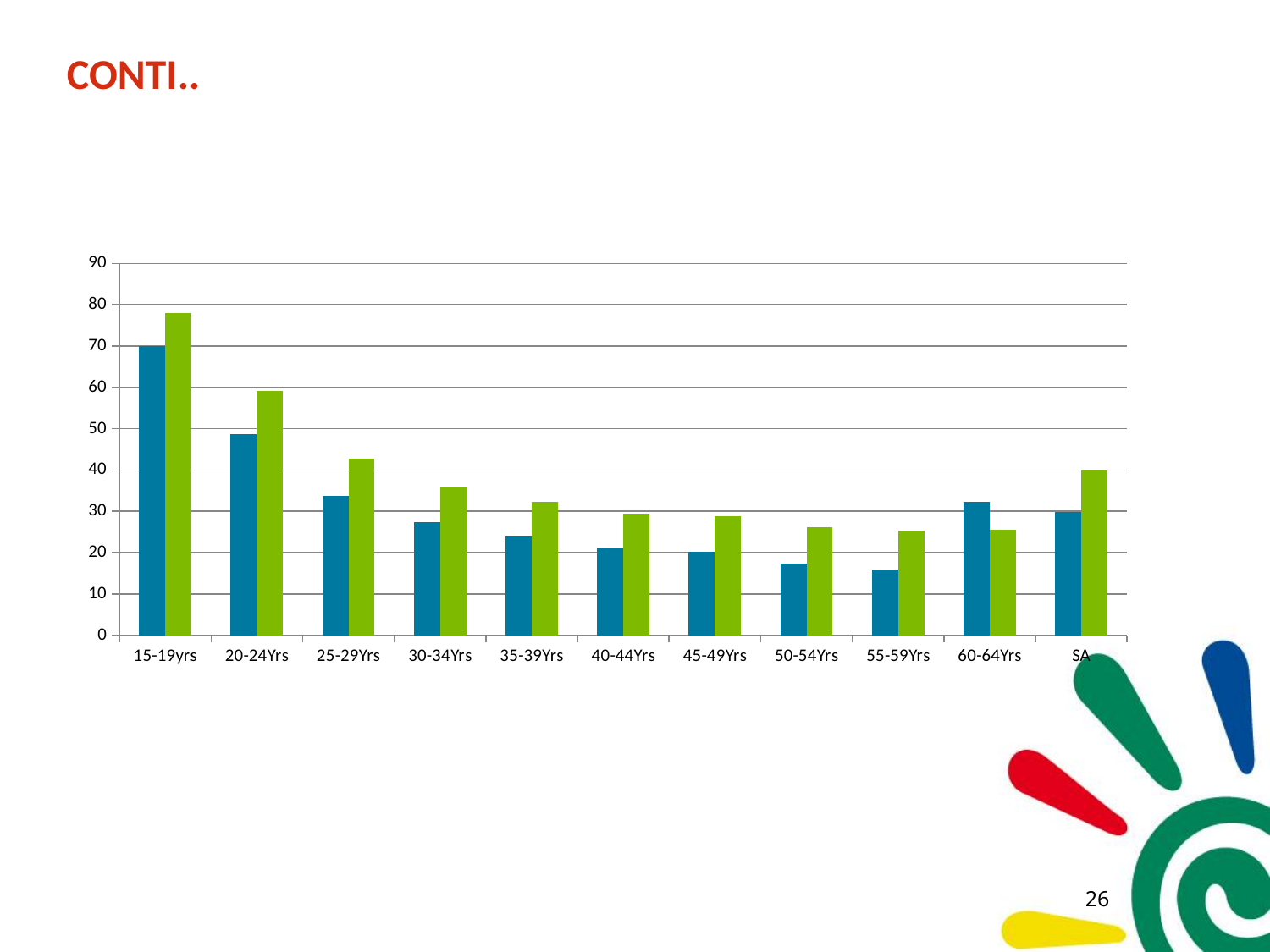
What two colours are used for the bars in the chart? Blue and green Is the green bar for 15-19yrs greater or less than 70? greater What kind of chart is shown on the slide? Bar chart Is the blue bar for 55-59Yrs greater or less than 20? less Is the green bar for SA greater or less than 30? greater How many data series (bar colours) are plotted for each category? 2 Which category has the tallest green bar? 15-19yrs How many categories are shown along the x axis of the chart? 11 For the 60-64Yrs category, which bar is taller, the blue one or the green one? The blue one Do the blue bars rise or fall from 15-19yrs through 55-59Yrs? Fall Which category has the shortest blue bar? 55-59Yrs